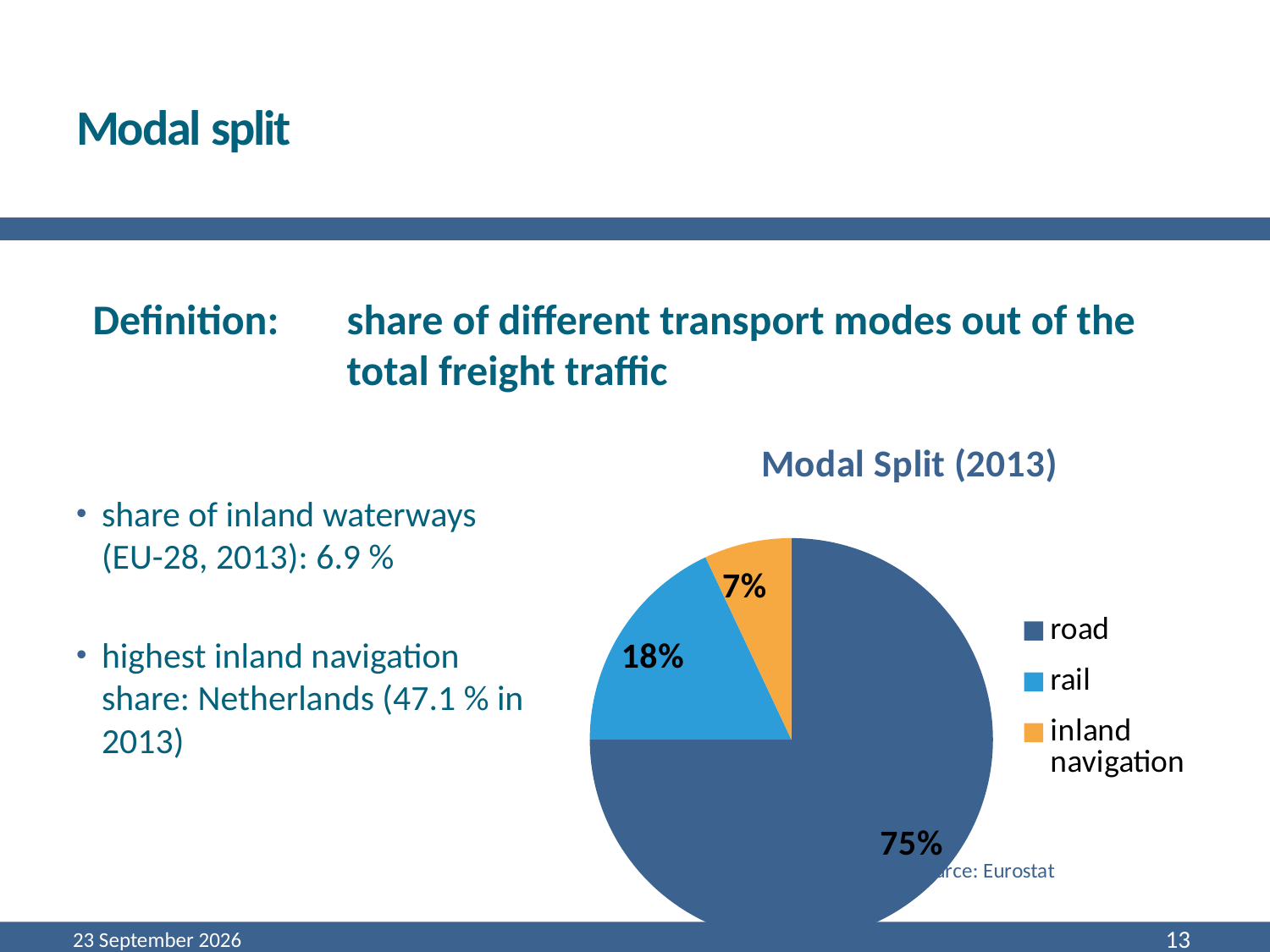
Which transport mode has the smallest share in the pie chart? inland navigation Is the share for road greater or less than 50%? greater Which transport mode has the largest share in the pie chart? road How many entries does the legend list? 3 What type of chart is shown on the slide? pie chart What is the difference in percentage points between the road share and the rail share? 57 What share of the pie does road account for? 75% What is the title of the chart? Modal Split (2013) How many slices does the pie chart have? 3 Which has a larger share, rail or inland navigation? rail What share of the pie does inland navigation account for? 7% What share of the pie does rail account for? 18%